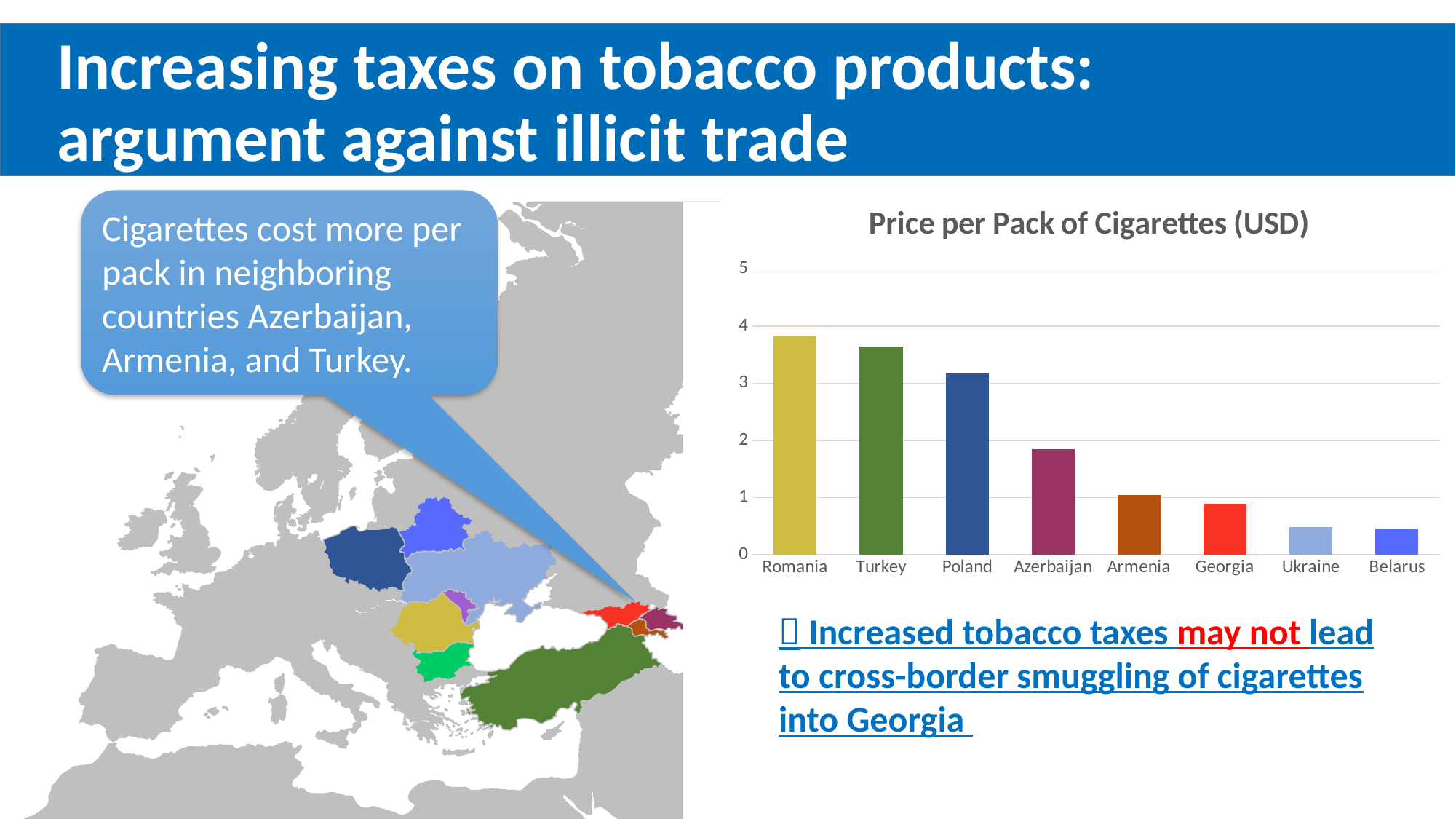
Which country has the highest price per pack of cigarettes in the chart? Romania Is the value for Romania greater or less than 4? less Is the value for Poland greater or less than 3? greater Is the value for Georgia greater or less than 1? less How many countries are shown on the x axis of the chart? 8 What kind of chart is shown on the slide? bar chart What is the title of the chart? Price per Pack of Cigarettes (USD) Which has a higher price per pack, Poland or Azerbaijan? Poland Do the values rise or fall moving from left to right along the x axis? fall Which has a higher price per pack, Georgia or Azerbaijan? Azerbaijan